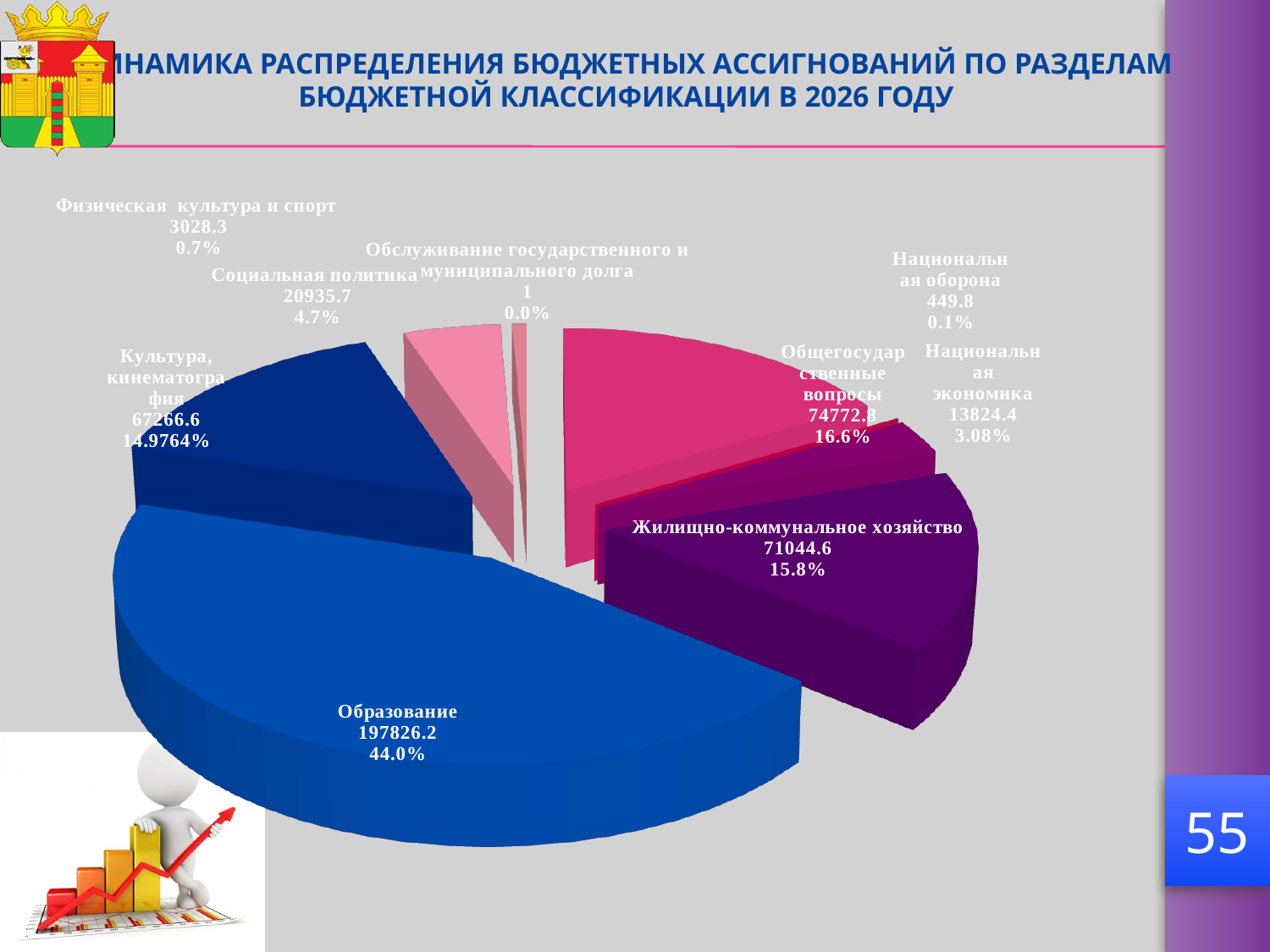
What share of the pie does Культура, кинематография have? 14.9764% What is the value shown for Жилищно-коммунальное хозяйство? 71044.6 What is the difference between the values for Образование and Жилищно-коммунальное хозяйство? 126781.6 What share of the pie does Национальная оборона have? 0.1% Which is larger: the value for Общегосударственные вопросы or for Жилищно-коммунальное хозяйство? Общегосударственные вопросы Which category has the smallest value in the pie chart? Обслуживание государственного и муниципального долга Which category has the largest slice of the pie? Образование What is the value shown for Национальная экономика? 13824.4 What share of the pie does Общегосударственные вопросы have? 16.6% What is the value shown for Образование? 197826.2 How many categories (sections) does the pie chart show? 9 What kind of chart is shown on the slide? Pie chart